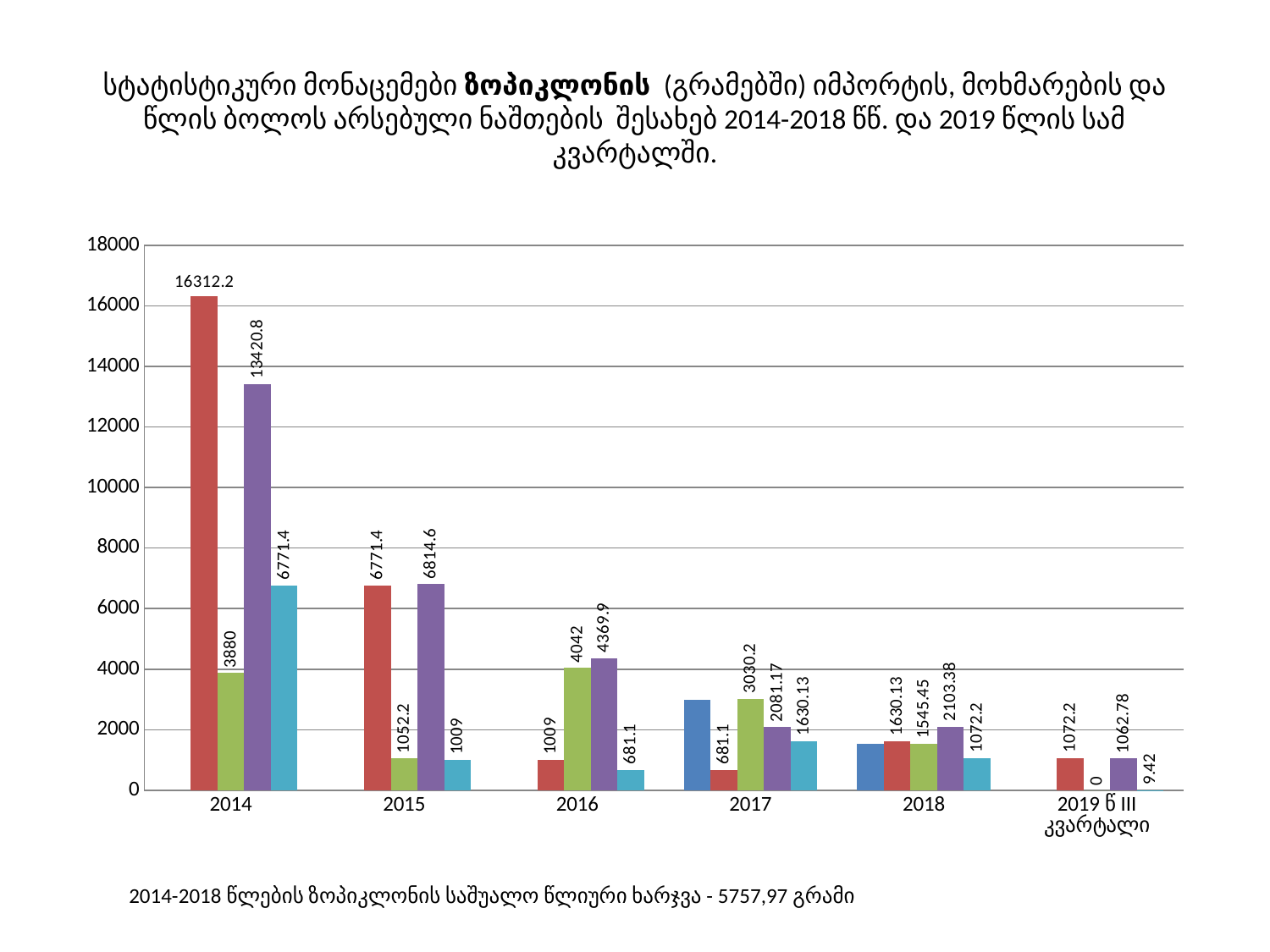
Does the red bar rise or fall from 2014 to 2016? fall What is the difference between the red bar and the purple bar for 2014? 2891.4 What is the value of the purple bar for 2014? 13420.8 What is the value of the red bar for 2014? 16312.2 How many categories are shown on the x axis of the chart? 6 Is the value of the blue bar for 2017 greater or less than 2000? greater Which category has the highest red bar? 2014 What kind of chart is shown on the slide? bar chart What is the value of the green bar for the 2019 III quarter category? 0 What is the value of the teal bar for 2017? 1630.13 What is the value of the green bar for 2016? 4042 Which is larger for 2015, the red bar or the purple bar? the purple bar